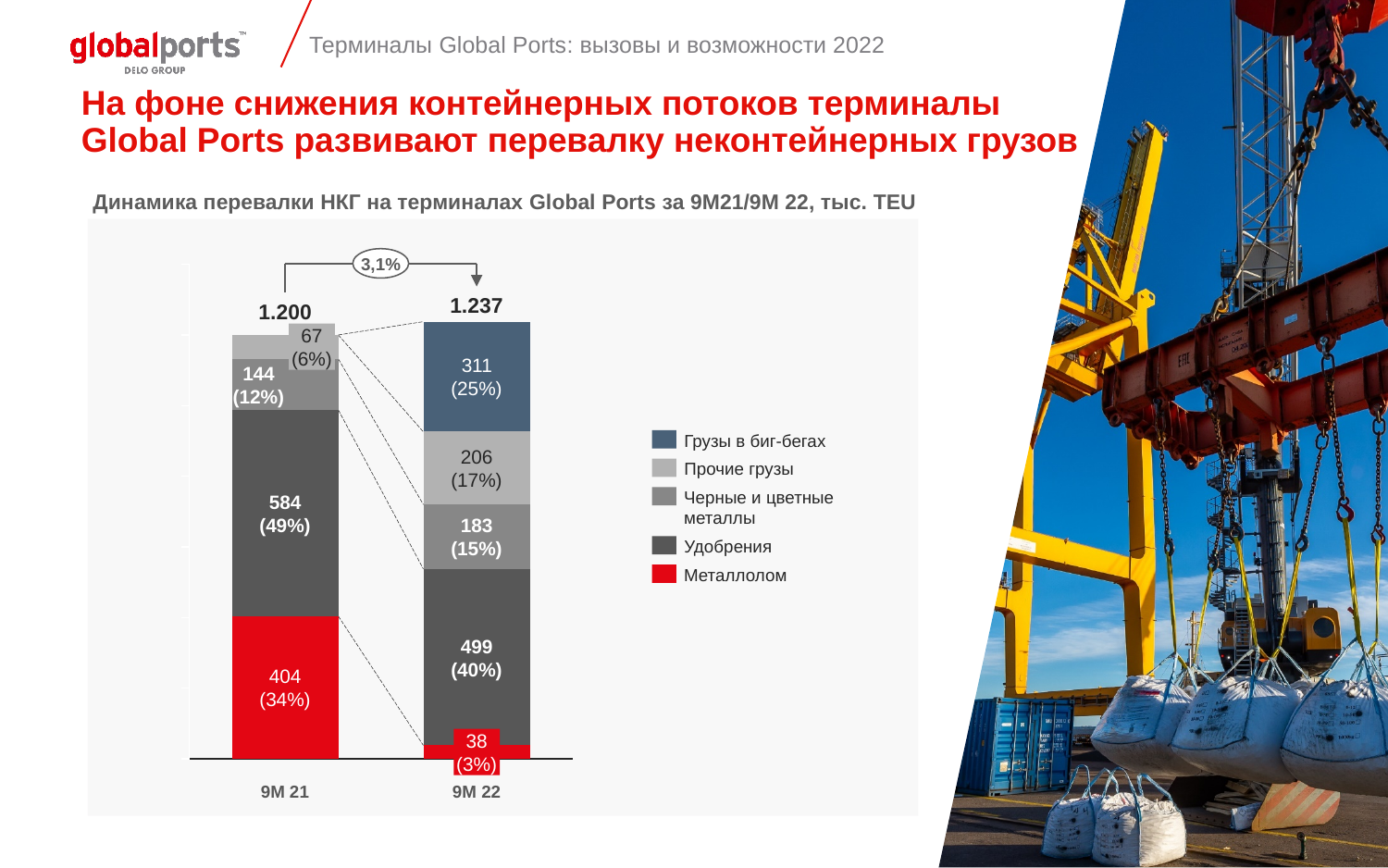
Which segment is the largest in the 9M 22 bar? Удобрения What is the total value of the 9M 21 bar? 1.200 Which is larger: Прочие грузы in 9M 22 or Черные и цветные металлы in 9M 22? Прочие грузы What type of chart is shown on the slide? Stacked bar chart What is the value for Грузы в биг-бегах in 9M 22? 311 What is the value for Металлолом in 9M 21? 404 What is the difference between the Металлолом values in 9M 21 and 9M 22? 366 What percentage share does Черные и цветные металлы have in 9M 21? 12% What is the value for Удобрения in 9M 22? 499 What is the total value of the 9M 22 bar? 1.237 How many series does the legend list? 5 What percentage change between 9M 21 and 9M 22 is shown above the bars? 3,1%